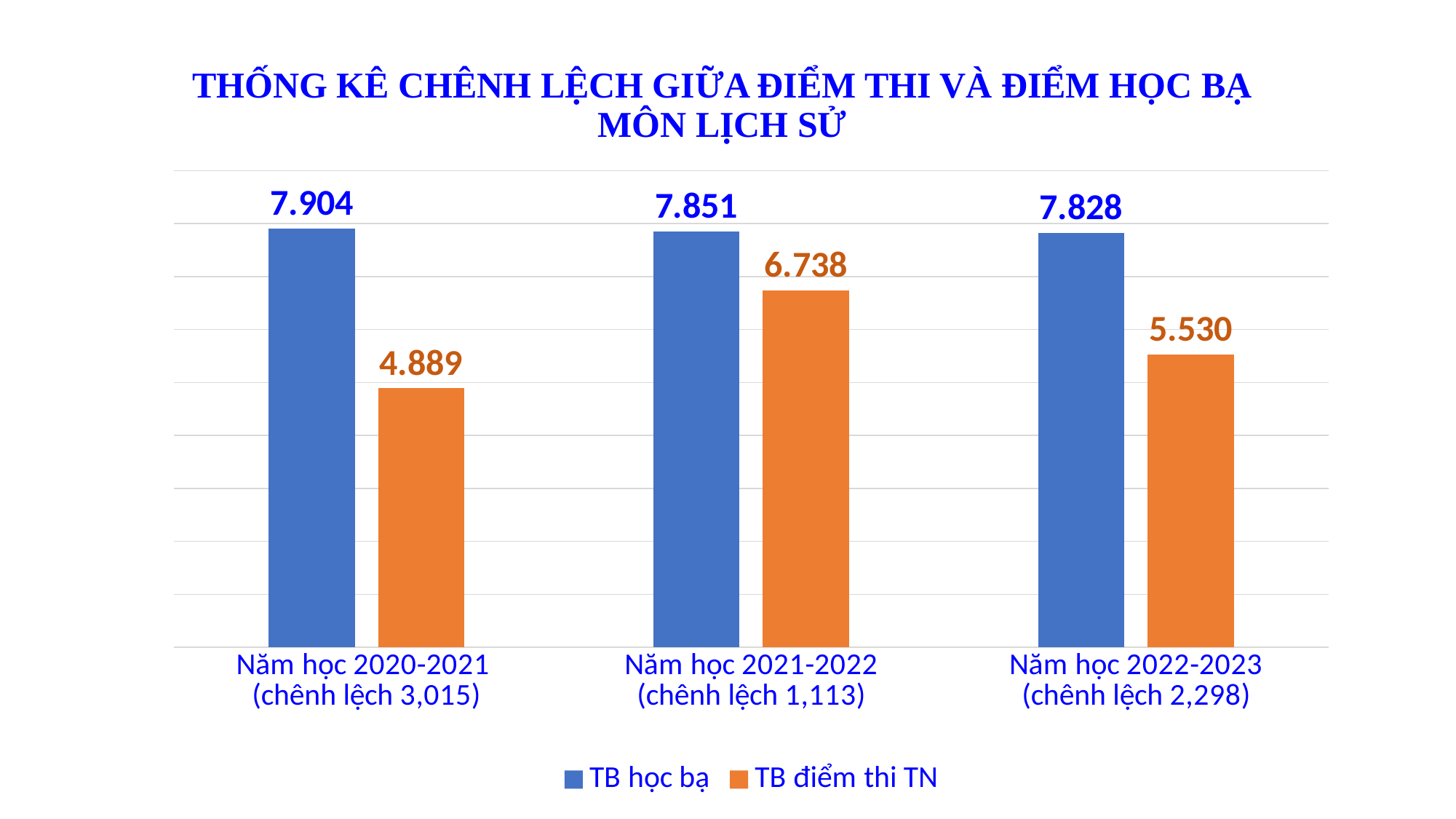
What is the value of TB học bạ for Năm học 2022-2023? 7.828 How many school years are shown on the x axis? 3 What is the value of TB điểm thi TN for Năm học 2022-2023? 5.530 Which school year has the highest TB điểm thi TN value? Năm học 2021-2022 Which school year has the lowest TB điểm thi TN value? Năm học 2020-2021 What kind of chart is shown on the slide? Bar chart How many series does the legend list? 2 Which is larger for Năm học 2022-2023: TB học bạ or TB điểm thi TN? TB học bạ What is the value of TB học bạ for Năm học 2020-2021? 7.904 Do the TB học bạ values rise or fall from Năm học 2020-2021 to Năm học 2022-2023? Fall What is the value of TB điểm thi TN for Năm học 2021-2022? 6.738 What is the difference between TB học bạ and TB điểm thi TN for Năm học 2020-2021? 3.015